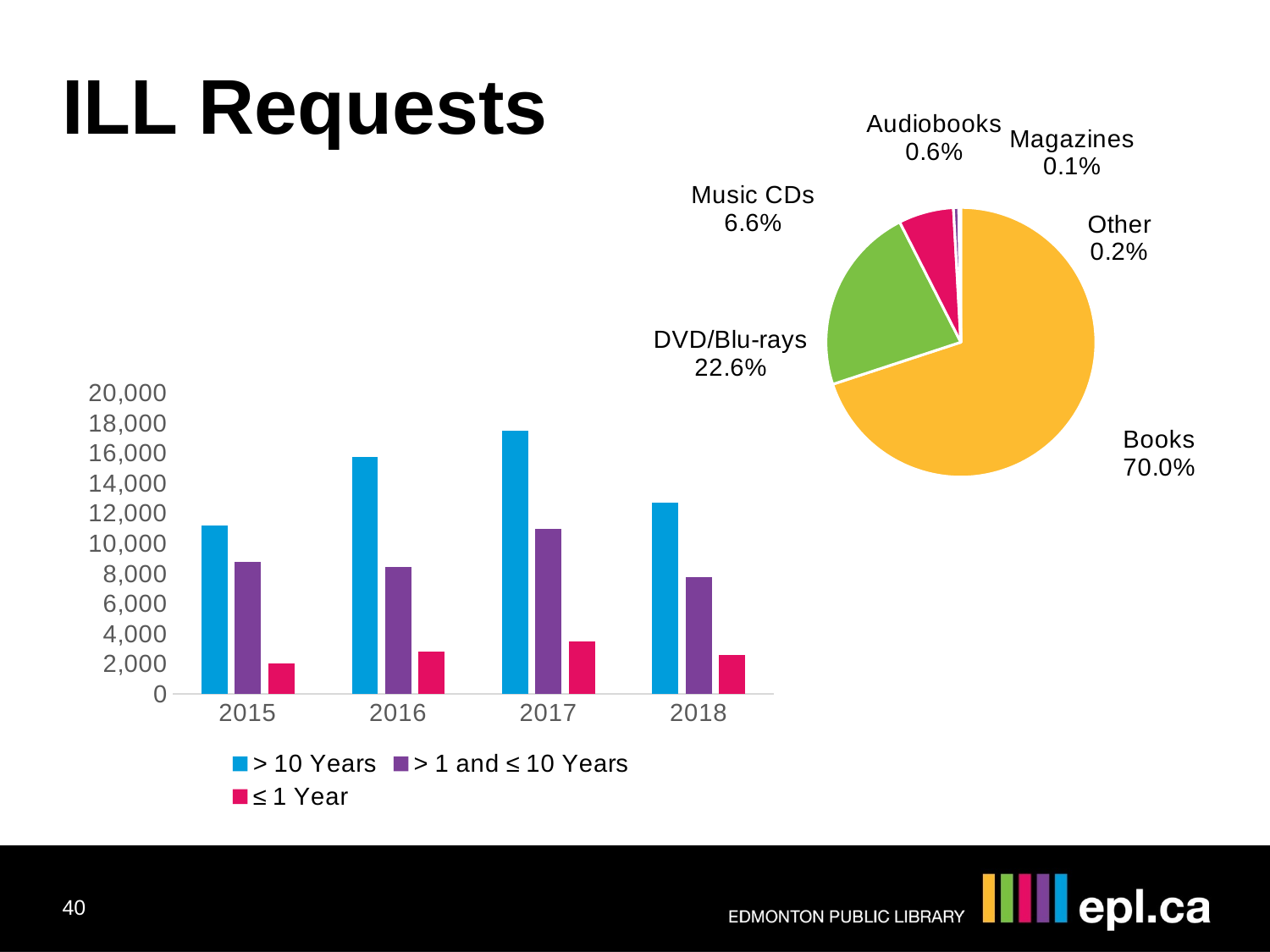
On the pie chart, what is the difference in percentage points between the Books share and the DVD/Blu-rays share? 47.4 What kind of chart is shown at the bottom left of the slide? bar chart On the pie chart, what share of ILL requests is for Books? 70.0% On the bar chart at the bottom left, is the value for '> 10 Years' in 2016 greater or less than 14,000? greater On the pie chart, how many categories are shown? 6 On the bar chart at the bottom left, is the value for '≤ 1 Year' in 2015 greater or less than 4,000? less On the pie chart, which category has the smallest share? Magazines On the pie chart, what share of ILL requests is for DVD/Blu-rays? 22.6% On the bar chart at the bottom left, in which year is the '> 10 Years' bar highest? 2017 On the pie chart, which is larger, the share for Audiobooks or the share for Other? Audiobooks On the pie chart, what share of ILL requests is for Music CDs? 6.6% On the bar chart at the bottom left, how many series does the legend list? 3